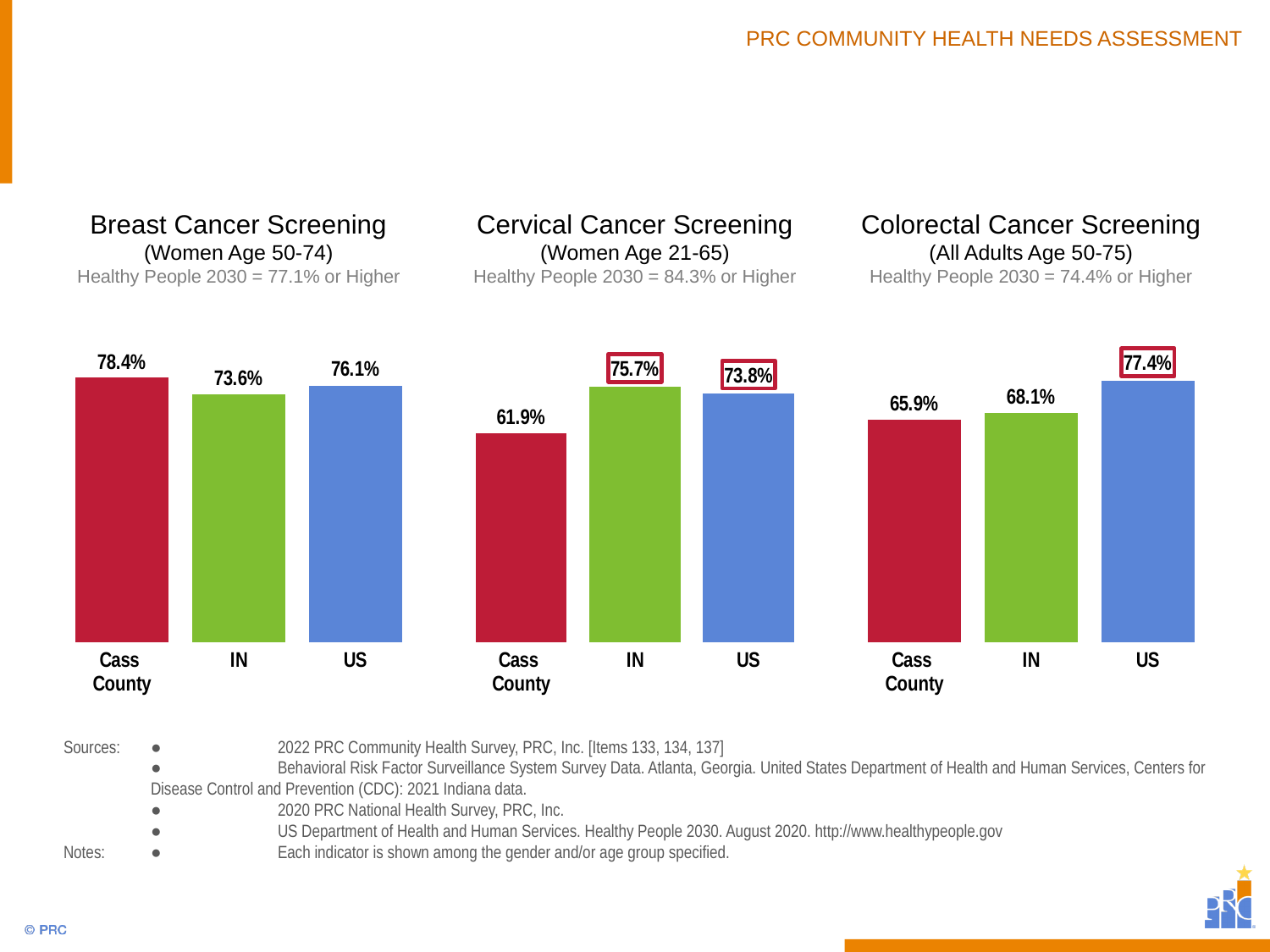
In the Colorectal Cancer Screening chart, which category has the lowest value? Cass County What Healthy People 2030 target is shown under the Cervical Cancer Screening chart title? 84.3% or Higher In the Breast Cancer Screening chart, which is larger, the value for Cass County or the value for US? Cass County What kind of chart is the Colorectal Cancer Screening chart? Bar chart In the Breast Cancer Screening chart, what is the value for Cass County? 78.4% In the Cervical Cancer Screening chart, what is the difference between the IN value and the Cass County value? 13.8% How many categories are shown in the Cervical Cancer Screening chart? 3 In the Breast Cancer Screening chart, which category has the lowest value? IN In the Cervical Cancer Screening chart, what is the value for IN? 75.7% In the Colorectal Cancer Screening chart, what is the difference between the US value and the IN value? 9.3% In the Cervical Cancer Screening chart, which category has the highest value? IN In the Colorectal Cancer Screening chart, what is the value for US? 77.4%